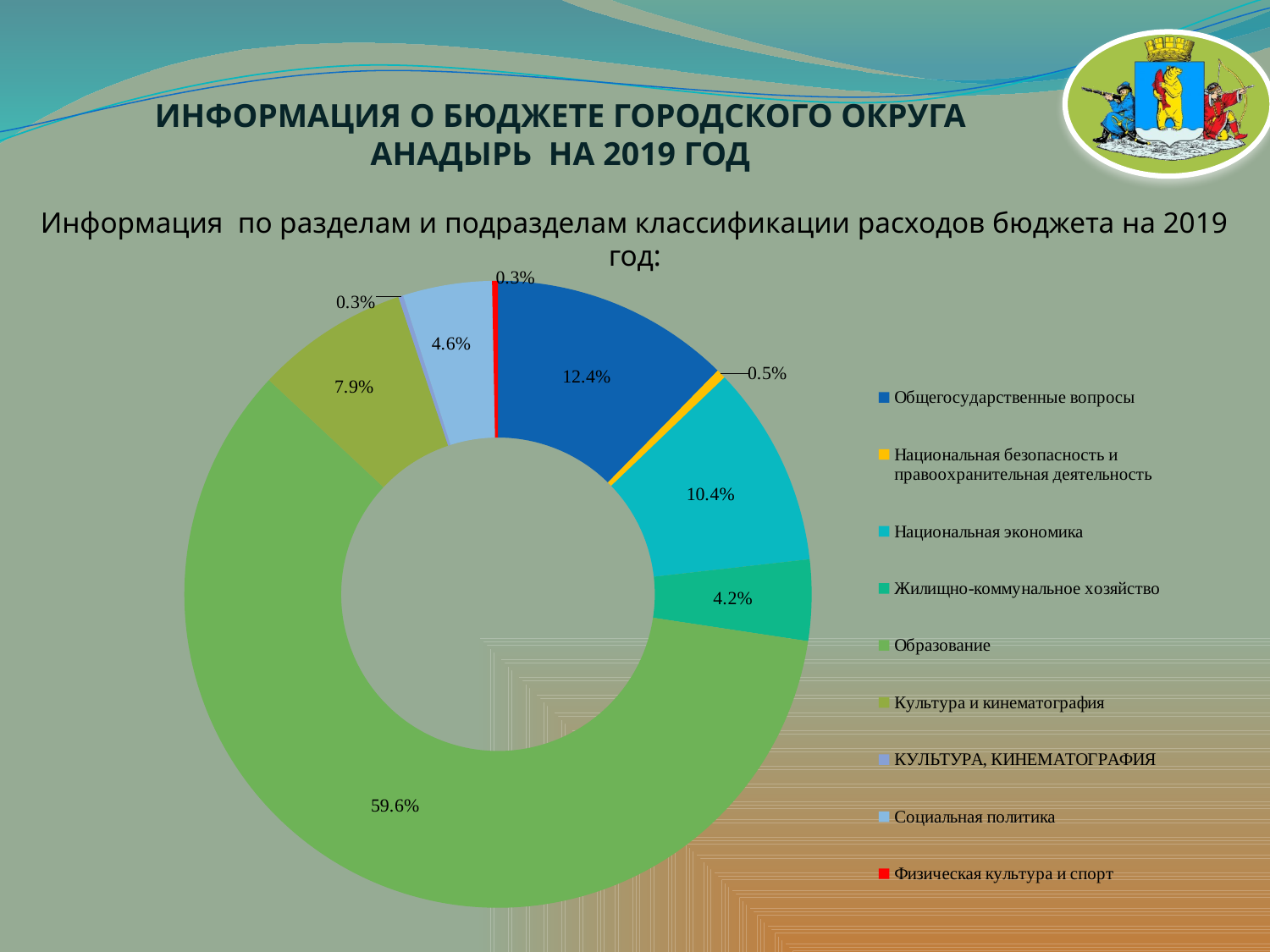
What colour is the Образование slice? green What share of the 2019 budget expenditure goes to Образование? 59.6% What is the value shown for Жилищно-коммунальное хозяйство? 4.2% What is the value shown for Общегосударственные вопросы? 12.4% What is the value shown for Социальная политика? 4.6% Which is larger: the share for Культура и кинематография or for Социальная политика? Культура и кинематография Which category has the largest share of the budget? Образование How many categories does the legend list? 9 What kind of chart is shown on the slide? pie chart (doughnut) What is the value shown for Национальная экономика? 10.4% What is the value shown for Физическая культура и спорт? 0.3% What is the difference between the shares of Общегосударственные вопросы and Национальная экономика? 2.0 percentage points